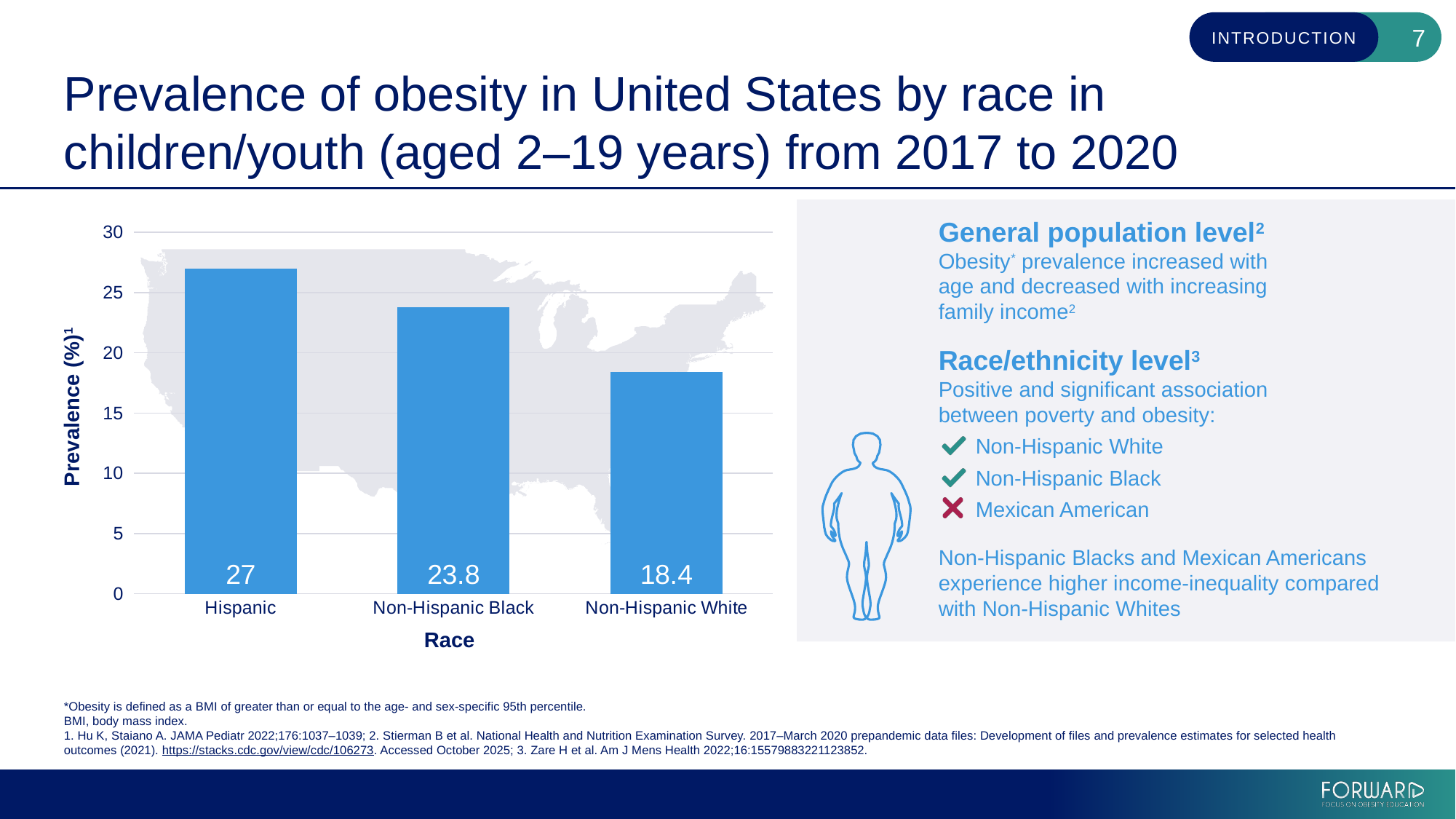
What kind of chart is shown on the slide? Bar chart What is the obesity prevalence value shown for Hispanic children/youth? 27 Is the value for Hispanic greater or less than 25? greater What is the label of the y axis of the chart? Prevalence (%) What is the obesity prevalence value shown for Non-Hispanic Black children/youth? 23.8 Which race category has the highest obesity prevalence in the chart? Hispanic Which has a higher obesity prevalence, Non-Hispanic Black or Non-Hispanic White? Non-Hispanic Black How many race categories are plotted in the chart? 3 What is the obesity prevalence value shown for Non-Hispanic White children/youth? 18.4 What is the difference in prevalence between Non-Hispanic Black and Non-Hispanic White children/youth? 5.4 Which race category has the lowest obesity prevalence in the chart? Non-Hispanic White What is the difference in prevalence between Hispanic and Non-Hispanic White children/youth? 8.6